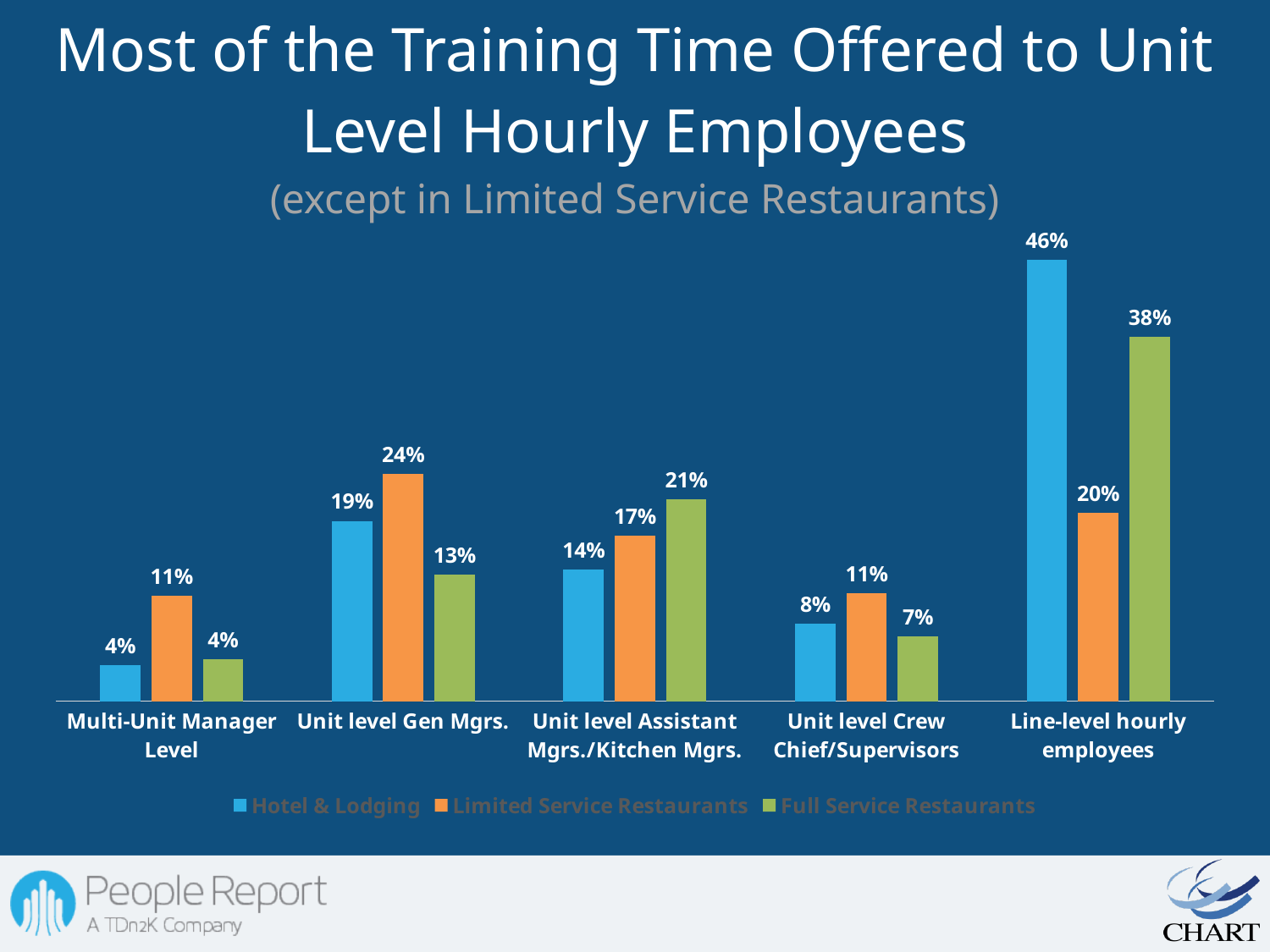
What kind of chart is shown on the slide? Bar chart Which category has the highest value for Full Service Restaurants? Line-level hourly employees How many series does the legend list? 3 What is the value for Limited Service Restaurants in the Unit level Gen Mgrs. category? 24% What is the value for Hotel & Lodging in the Line-level hourly employees category? 46% Which is larger for Unit level Crew Chief/Supervisors: Hotel & Lodging or Limited Service Restaurants? Limited Service Restaurants What is the value for Full Service Restaurants in the Unit level Assistant Mgrs./Kitchen Mgrs. category? 21% What is the difference between the Limited Service Restaurants and Full Service Restaurants values for Unit level Gen Mgrs.? 11% How many categories are shown on the x axis? 5 What is the difference between the Hotel & Lodging and Full Service Restaurants values for Line-level hourly employees? 8% Which series is shown in orange? Limited Service Restaurants